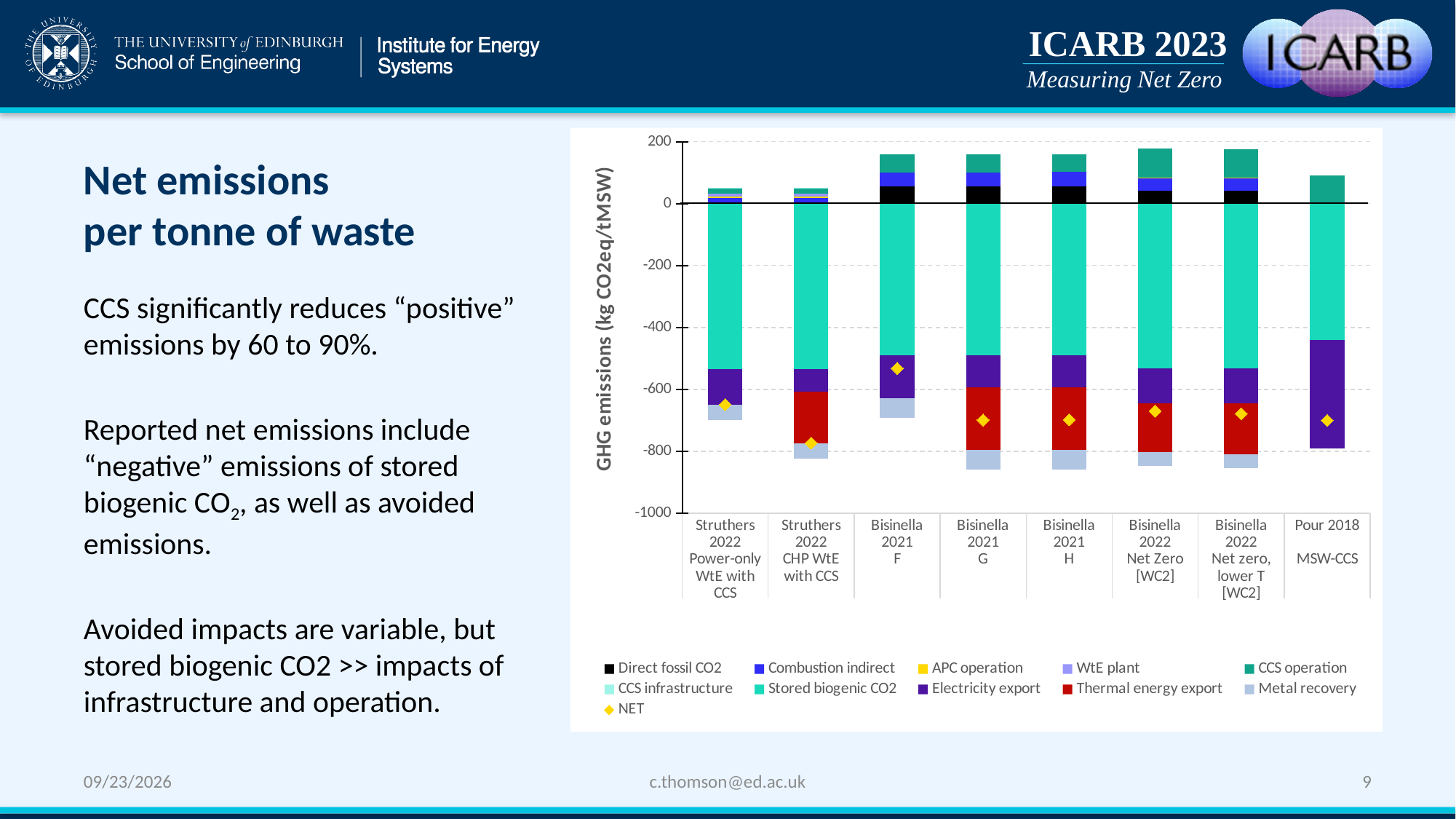
Is the NET value for Pour 2018 MSW-CCS greater or less than -400? less Which legend entry is shown as a diamond marker rather than a bar segment? NET Which category has the lowest (most negative) NET value? Struthers 2022 CHP WtE with CCS What kind of chart is shown on the slide? Stacked bar chart What is the label of the vertical axis of the chart? GHG emissions (kg CO2eq/tMSW) How many series does the chart legend list? 11 Is the NET value for Bisinella 2021 F greater or less than -600? greater Which category has the highest (least negative) NET value? Bisinella 2021 F How many categories (scenarios) are shown along the x axis of the chart? 8 Is the NET value for Bisinella 2021 F higher or lower than the NET value for Struthers 2022 CHP WtE with CCS? higher Is the NET value for Struthers 2022 CHP WtE with CCS greater or less than -600? less